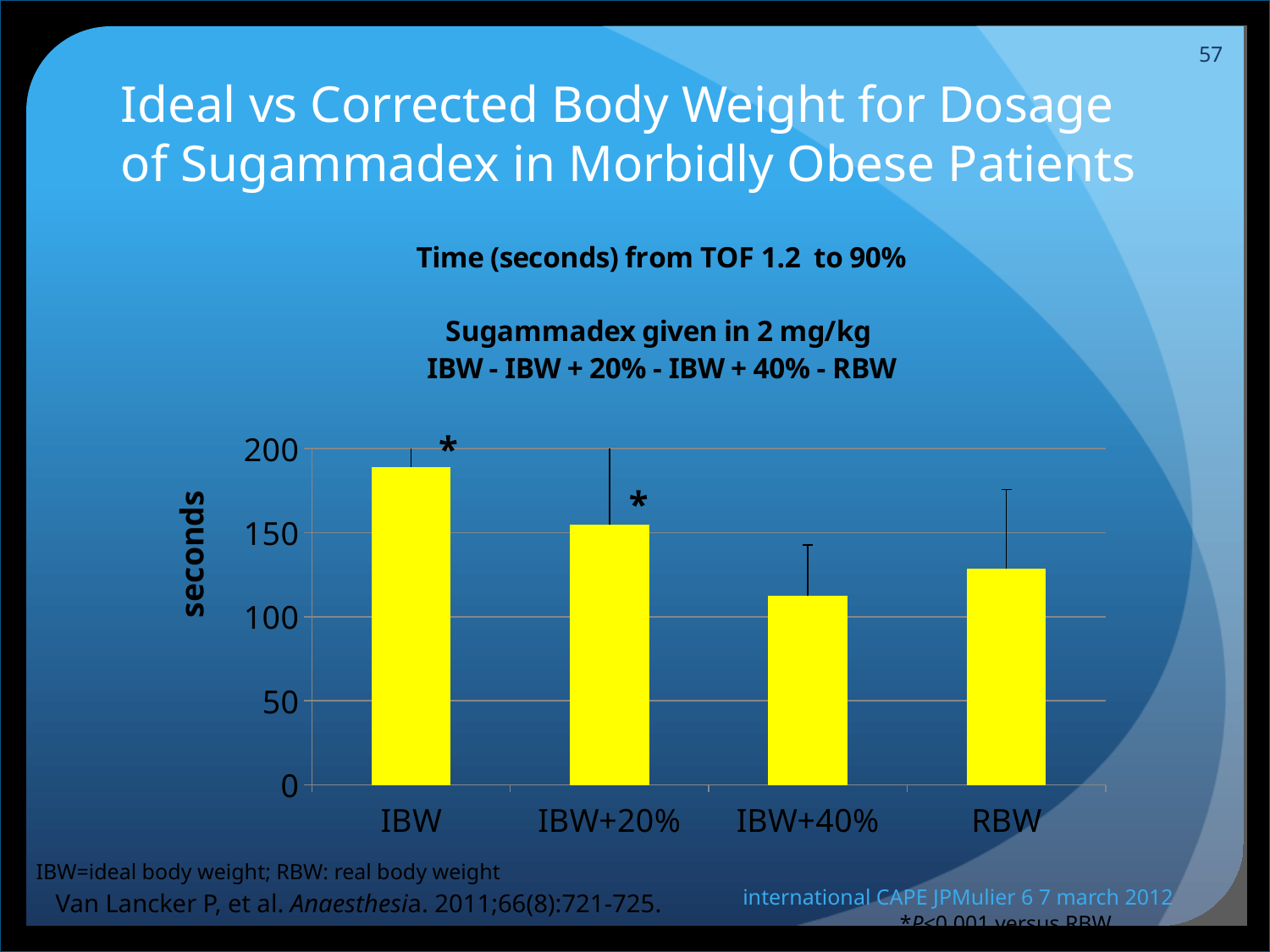
Is the value for RBW greater or less than 100? greater Is the value for IBW greater or less than 150? greater Do the values rise or fall from IBW to IBW+40% along the x axis? fall Is the value for IBW+20% greater or less than 200? less How many categories (bars) are plotted in the chart? 4 Which is larger, the value for IBW+20% or the value for RBW? IBW+20% Which category has the lowest value in the chart? IBW+40% Which is larger, the value for IBW+40% or the value for IBW? IBW What is the label on the vertical axis of the chart? seconds What kind of chart is shown on the slide? bar chart Which category has the highest value in the chart? IBW